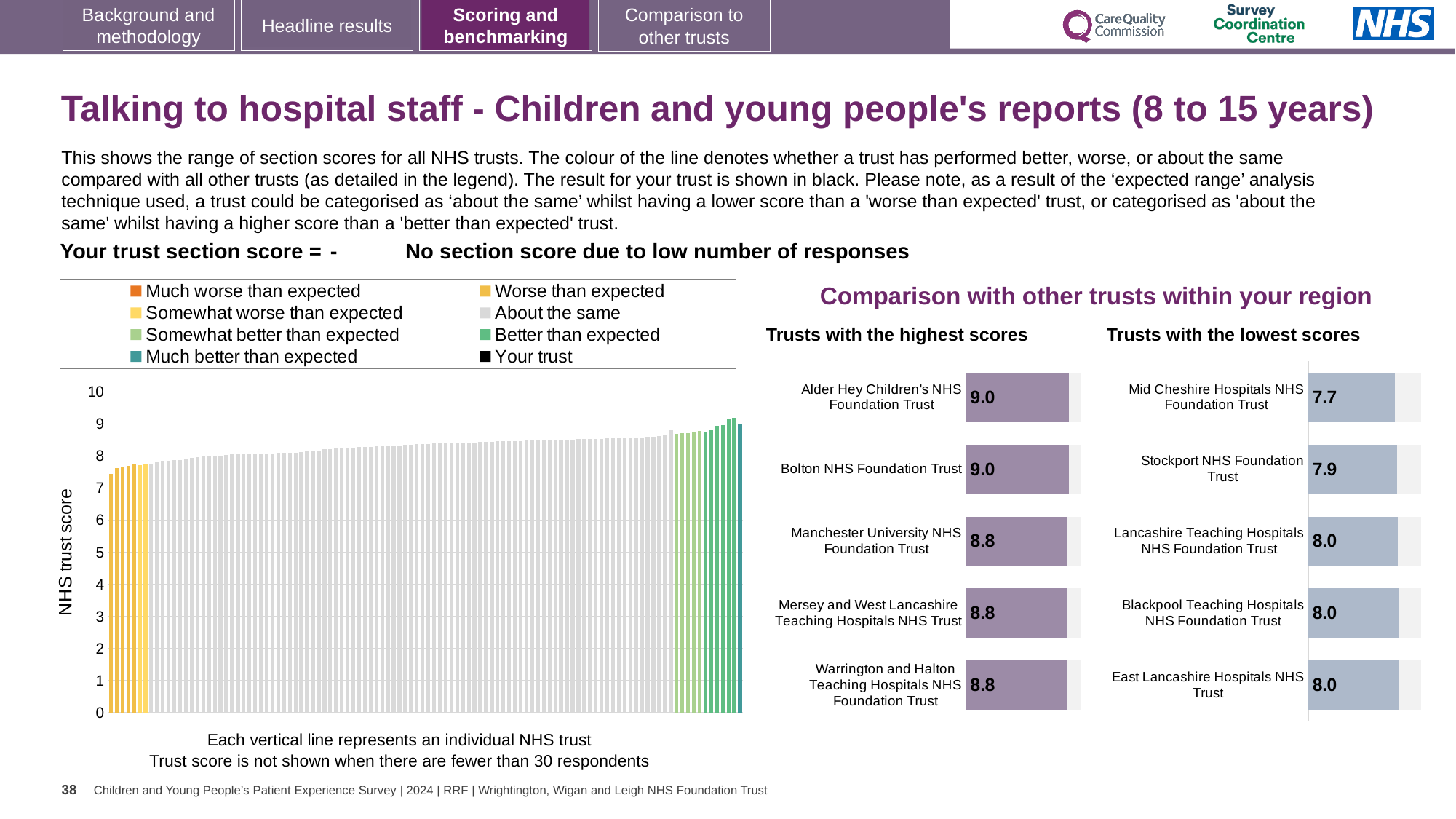
How many trusts are listed in the 'Trusts with the highest scores' chart? 5 In the 'Trusts with the lowest scores' chart, which trust has the lowest score? Mid Cheshire Hospitals NHS Foundation Trust In the 'Trusts with the lowest scores' chart, what is the difference between the scores of Stockport NHS Foundation Trust and Mid Cheshire Hospitals NHS Foundation Trust? 0.2 In the 'Trusts with the highest scores' chart, what is the difference between the scores of Alder Hey Children's NHS Foundation Trust and Warrington and Halton Teaching Hospitals NHS Foundation Trust? 0.2 In the 'Trusts with the highest scores' chart, what is the score for Manchester University NHS Foundation Trust? 8.8 In the 'Trusts with the lowest scores' chart, what is the score for Stockport NHS Foundation Trust? 7.9 In the 'Trusts with the highest scores' chart, which has the higher score: Bolton NHS Foundation Trust or Mersey and West Lancashire Teaching Hospitals NHS Trust? Bolton NHS Foundation Trust What kind of chart is the large chart on the left showing NHS trust scores? Bar chart In the 'Trusts with the highest scores' chart, what is the score for Alder Hey Children's NHS Foundation Trust? 9.0 In the 'Trusts with the lowest scores' chart, what is the score for Mid Cheshire Hospitals NHS Foundation Trust? 7.7 What is the y-axis title of the large chart on the left? NHS trust score In the large chart on the left, is the value of the lowest-scoring trust greater or less than 8? less